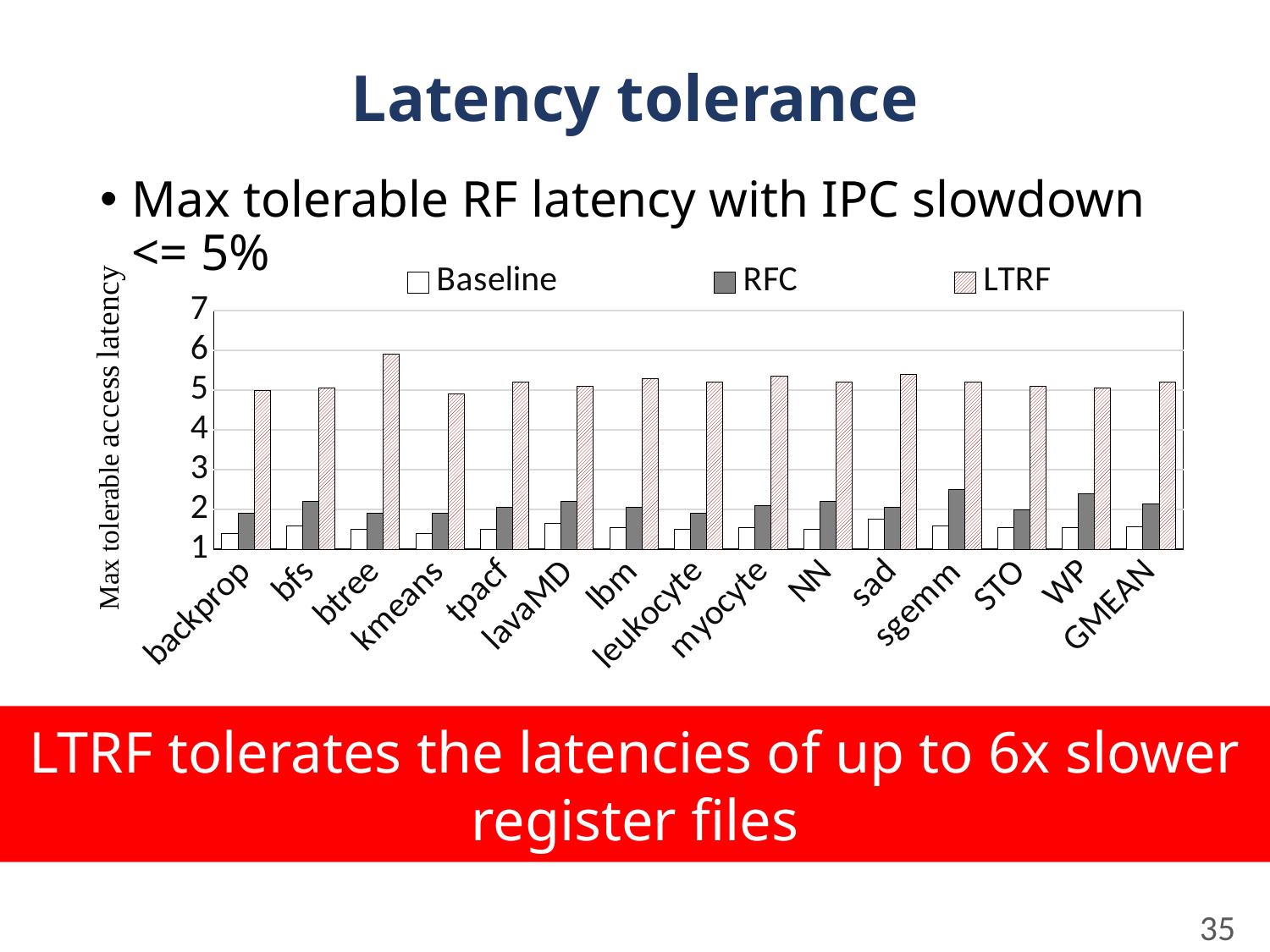
What is the label on the y axis of the chart? Max tolerable access latency For GMEAN, which series has the larger value, RFC or LTRF? LTRF Is the LTRF value for sad greater or less than 5? greater Is the LTRF value for btree greater or less than 5? greater How many series does the legend list? 3 Is the Baseline value for backprop greater or less than 2? less Which category has the highest LTRF value? btree What kind of chart is shown on the slide? bar chart For backprop, which series has the larger value, Baseline or RFC? RFC How many categories are shown along the x axis? 15